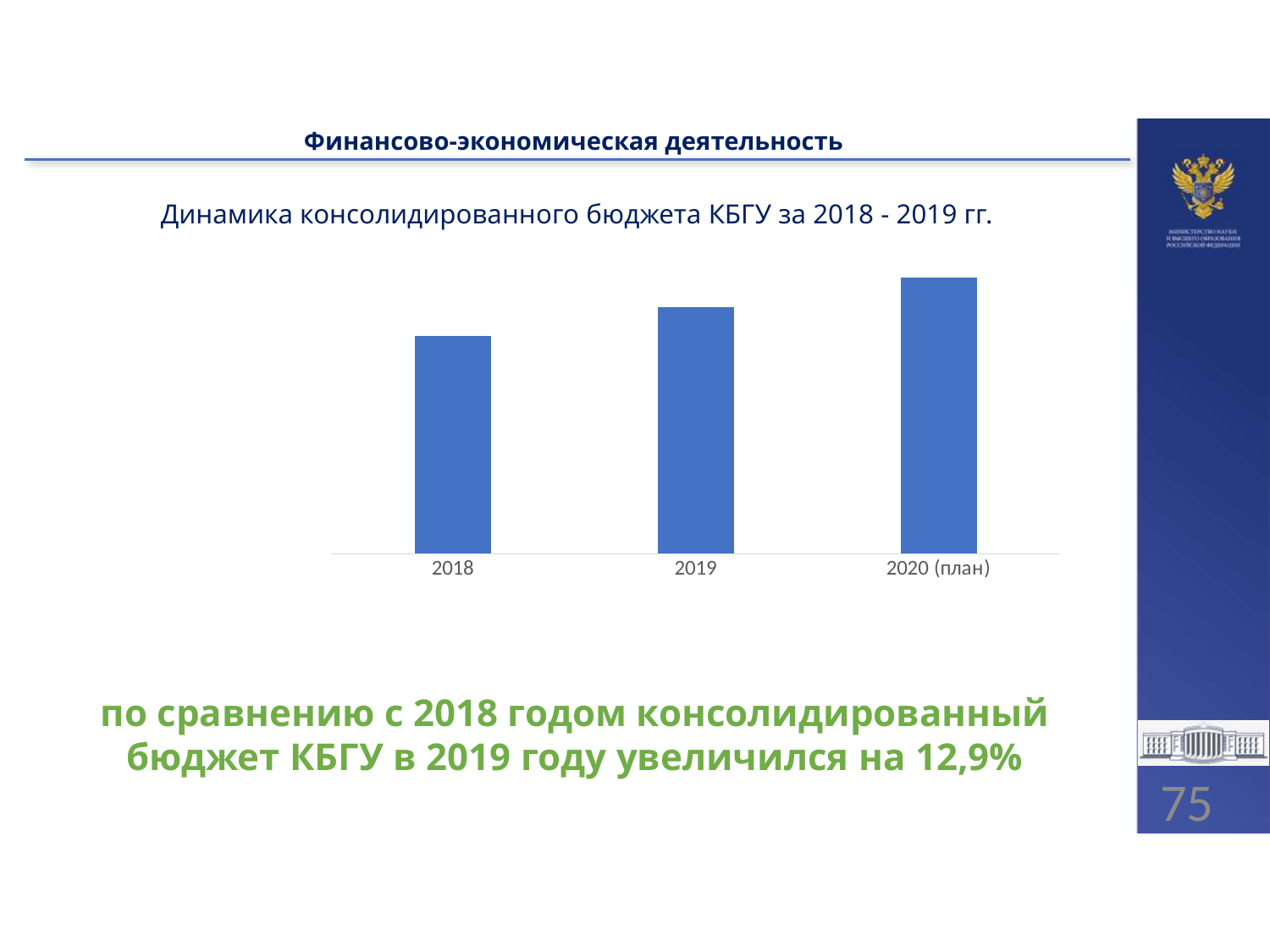
What kind of chart is shown on the slide? bar chart Which category has the lowest bar in the chart? 2018 How many bars (categories) does the chart show? 3 Which category has the highest bar in the chart? 2020 (план) What is the label of the third category on the x axis? 2020 (план) What is the title of the chart on the slide? Динамика консолидированного бюджета КБГУ за 2018 - 2019 гг. Which is larger, the bar for 2019 or the bar for 2020 (план)? 2020 (план) Do the values rise or fall from 2018 to 2020 (план) along the x axis? rise Which is larger, the bar for 2018 or the bar for 2019? 2019